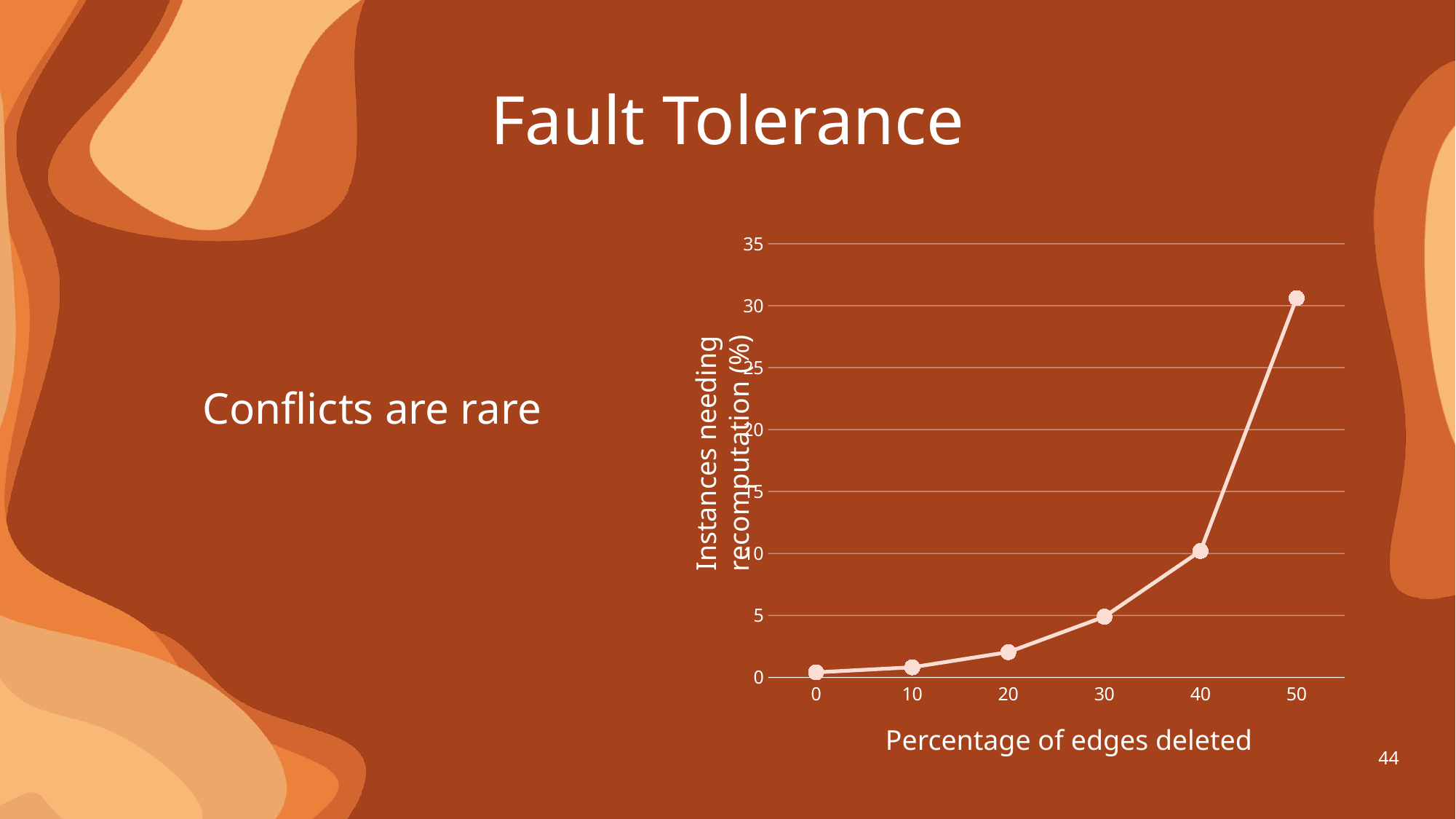
Do the values rise or fall as the percentage of edges deleted increases? rise What kind of chart is shown on the slide? line chart Is the value at 40% of edges deleted greater or less than 5? greater Is the value at 50% of edges deleted greater or less than 25? greater How many data points are plotted on the line? 6 Is the value at 30% of edges deleted greater or less than 10? less Which has the larger value: 40% or 50% of edges deleted? 50 What is the label of the y axis? Instances needing recomputation (%) Which has the larger value: 20% or 30% of edges deleted? 30 At which percentage of edges deleted is the value highest? 50 What is the label of the x axis? Percentage of edges deleted